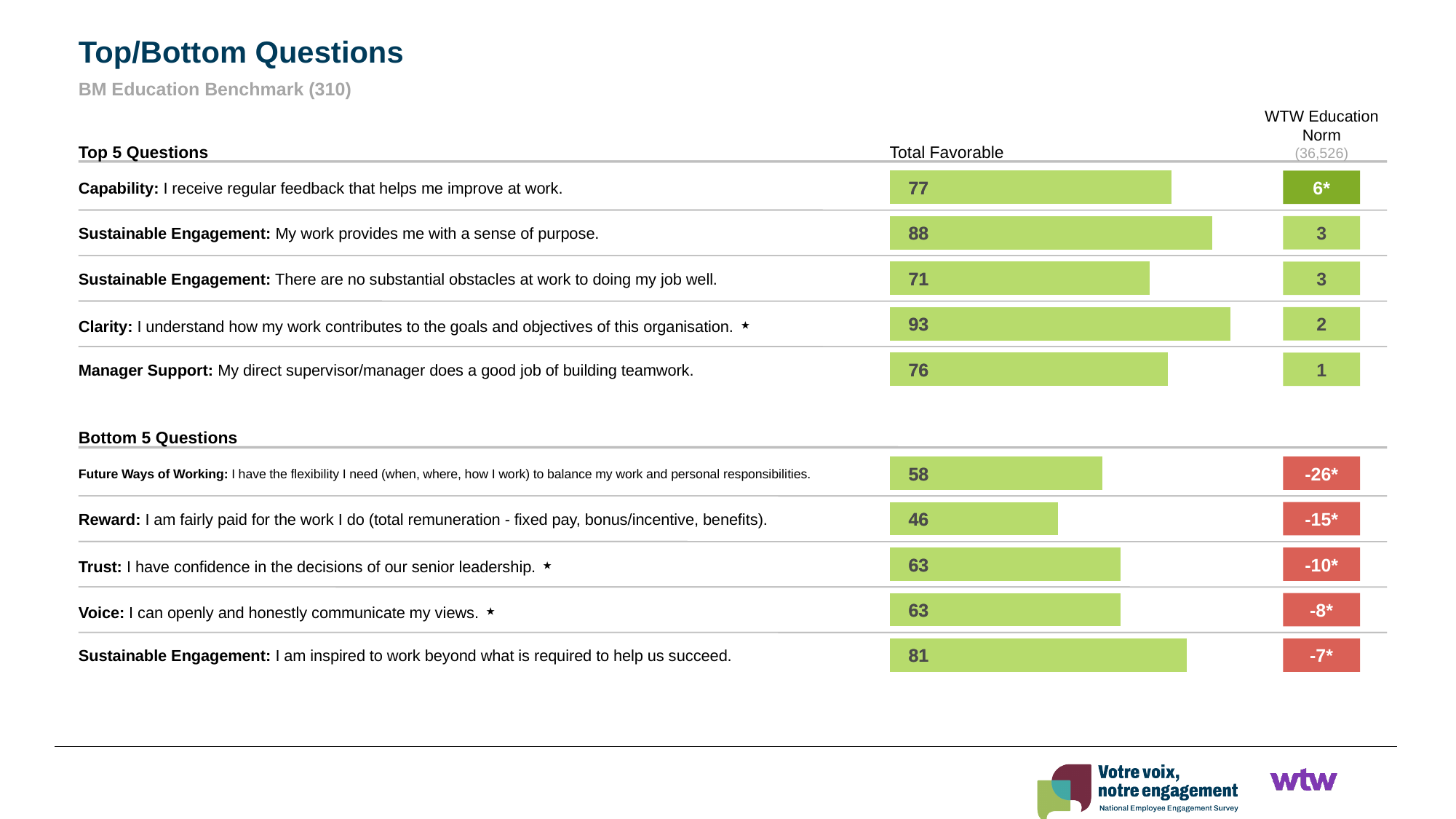
In the Top 5 Questions chart, what is the Total Favorable value for the Clarity question? 93 In the Top 5 Questions chart, what is the Total Favorable value for the Manager Support question? 76 What kind of chart is used to show the Total Favorable values on this slide? Bar chart In the Bottom 5 Questions chart, what is the Total Favorable value for the Reward question? 46 In the Top 5 Questions chart, which question has the highest Total Favorable value? Clarity: I understand how my work contributes to the goals and objectives of this organisation. How many questions are shown in the Bottom 5 Questions chart? 5 In the Top 5 Questions chart, what is the WTW Education Norm difference shown for the Capability question? 6* In the Top 5 Questions chart, what is the difference in Total Favorable between the Sustainable Engagement 'sense of purpose' question (88) and the Capability question (77)? 11 In the Bottom 5 Questions chart, which question has the lowest Total Favorable value? Reward: I am fairly paid for the work I do (total remuneration - fixed pay, bonus/incentive, benefits). What is the sample size shown under the WTW Education Norm column header? (36,526) In the Bottom 5 Questions chart, which has a higher Total Favorable value: the Future Ways of Working question or the Reward question? Future Ways of Working In the Bottom 5 Questions chart, what is the WTW Education Norm difference shown for the Future Ways of Working question? -26*